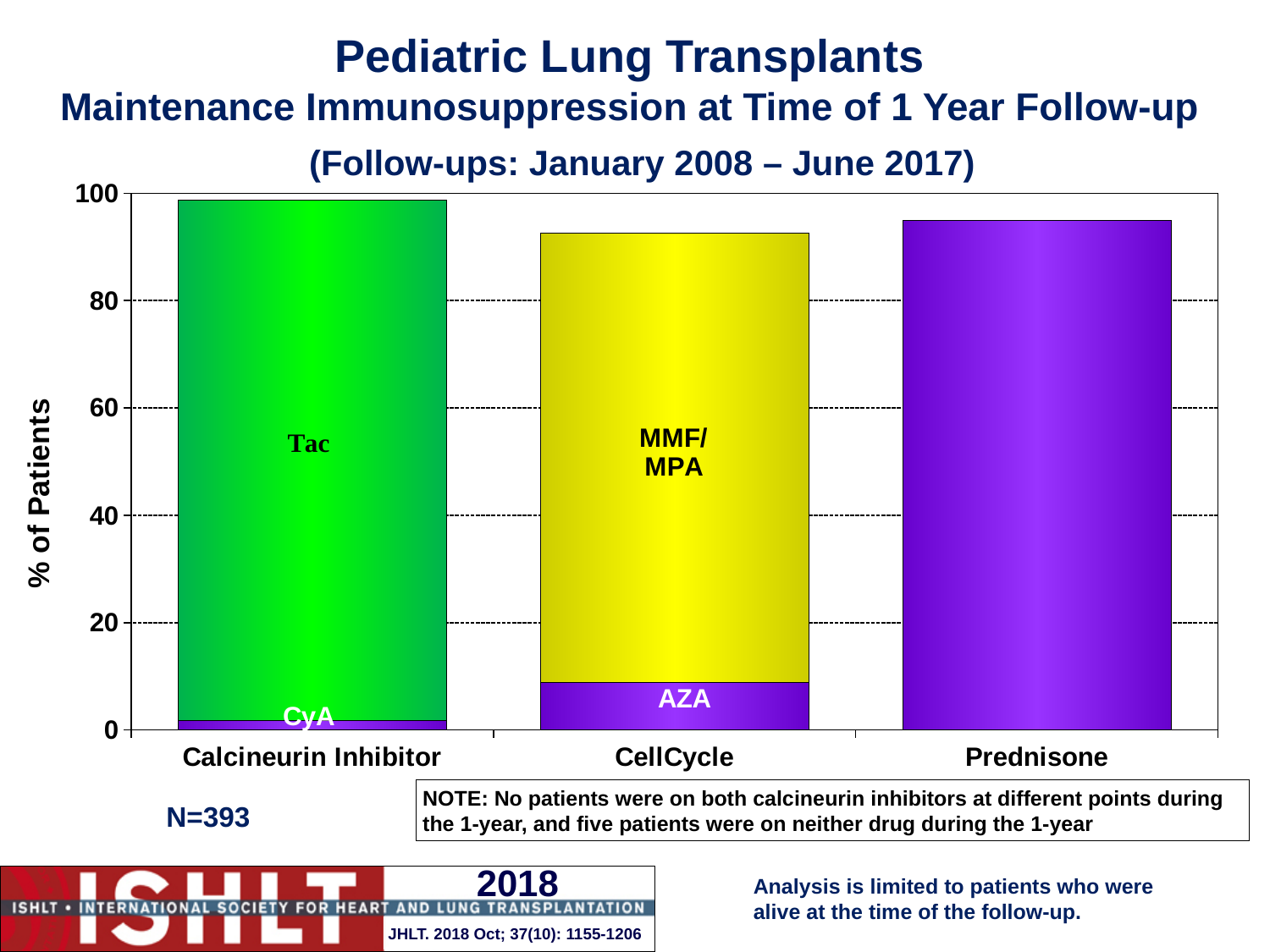
What kind of chart is shown on the slide? bar chart How many categories are shown on the x axis of the chart? 3 Is the total value for the CellCycle bar greater or less than 80? greater What is the label on the y axis of the chart? % of Patients Is the total value for the Calcineurin Inhibitor bar greater or less than 80? greater Which category has the tallest bar overall? Calcineurin Inhibitor Is the value of the CyA segment in the Calcineurin Inhibitor bar greater or less than 20? less Which segment is larger, AZA or CyA? AZA What is the sample size (N) stated on the slide? N=393 Which is larger, the total for Calcineurin Inhibitor or the total for CellCycle? Calcineurin Inhibitor